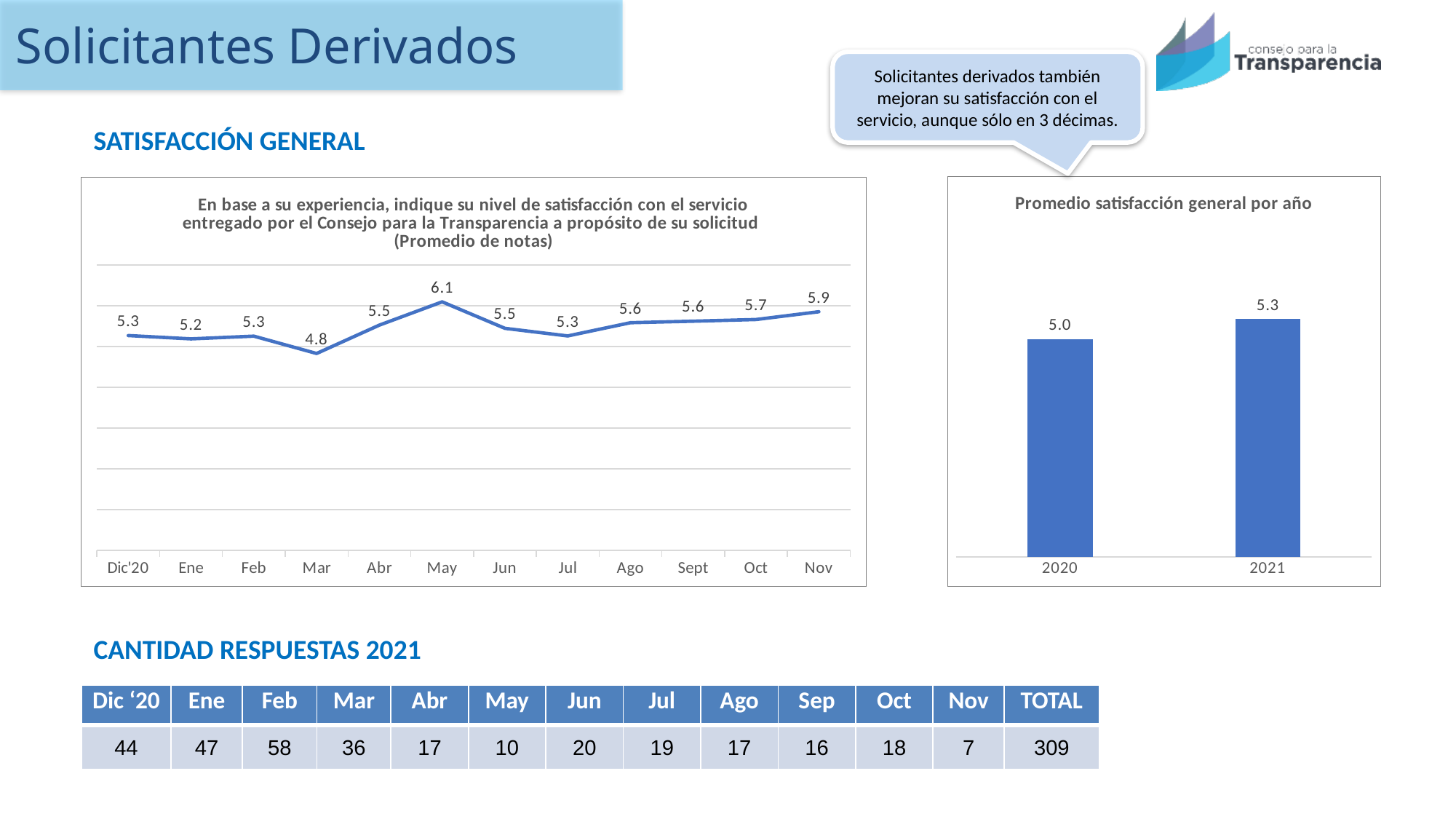
In the line chart on the left, what is the value for Mar? 4.8 In the line chart on the left, which month has the lowest value? Mar In the line chart on the left, how many data points are plotted? 12 In the line chart on the left, is the value for Nov larger or smaller than the value for Dic'20? larger In the chart titled 'Promedio satisfacción general por año', what is the value for 2021? 5.3 In the chart titled 'Promedio satisfacción general por año', what is the value for 2020? 5.0 In the line chart on the left, what is the value for May? 6.1 In the chart titled 'Promedio satisfacción general por año', what is the difference between 2021 and 2020? 0.3 What kind of chart is the chart on the left under 'SATISFACCIÓN GENERAL'? line chart In the line chart on the left, which month has the highest value? May In the line chart on the left, what is the difference between the values for May and Mar? 1.3 What kind of chart is the chart titled 'Promedio satisfacción general por año'? bar chart